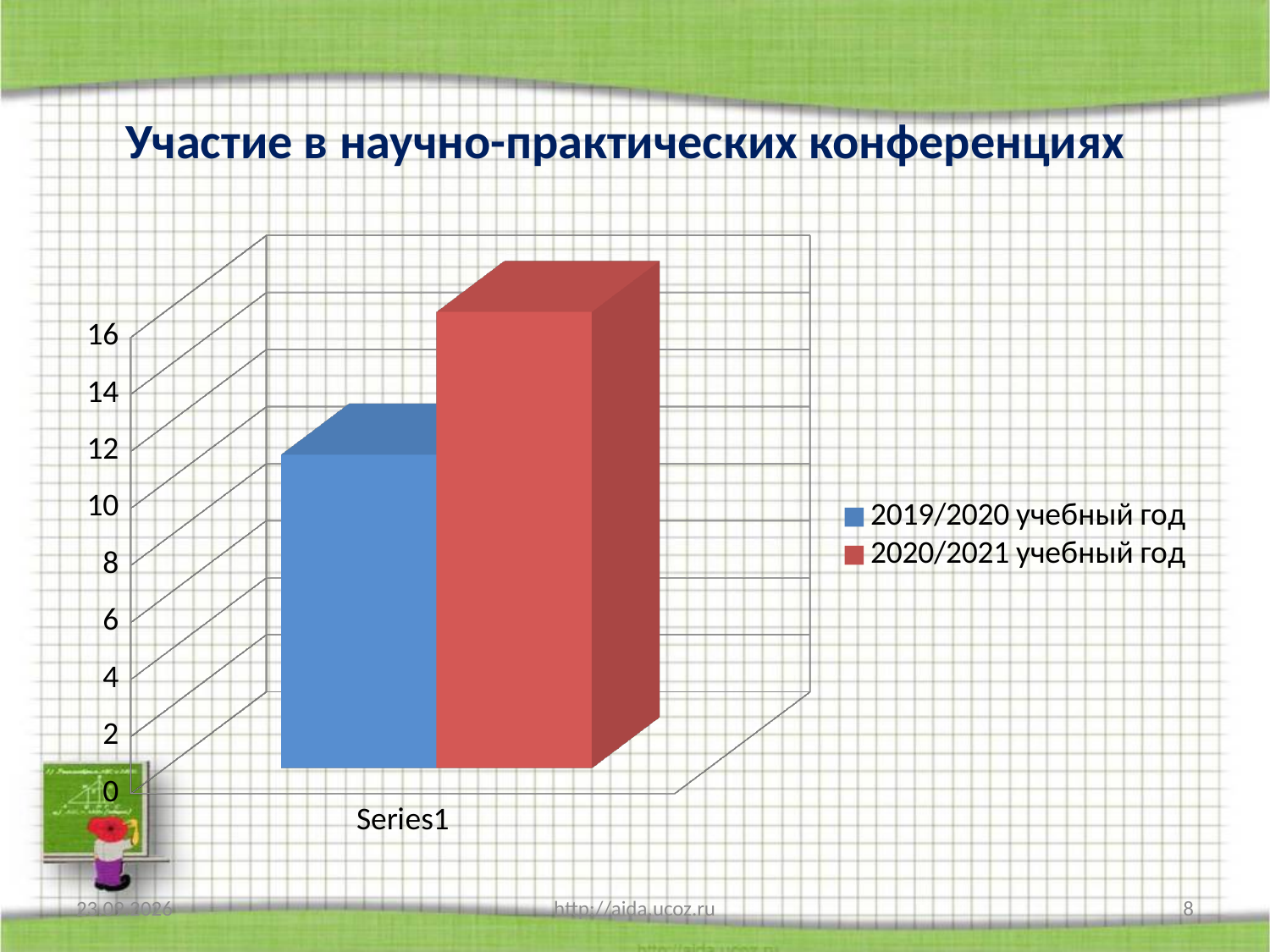
Is the value for 2019/2020 учебный год greater or less than 10? greater Is the value for 2020/2021 учебный год greater or less than 14? greater Is the value for 2019/2020 учебный год greater or less than 14? less Which series has the lowest bar? 2019/2020 учебный год What is the label of the category on the x axis? Series1 What is the title of the chart? Участие в научно-практических конференциях How many series does the legend list? 2 How many categories are shown on the x axis? 1 What colour is the bar for 2020/2021 учебный год? red What kind of chart is shown on the slide? bar chart Which series has the higher bar, 2019/2020 учебный год or 2020/2021 учебный год? 2020/2021 учебный год